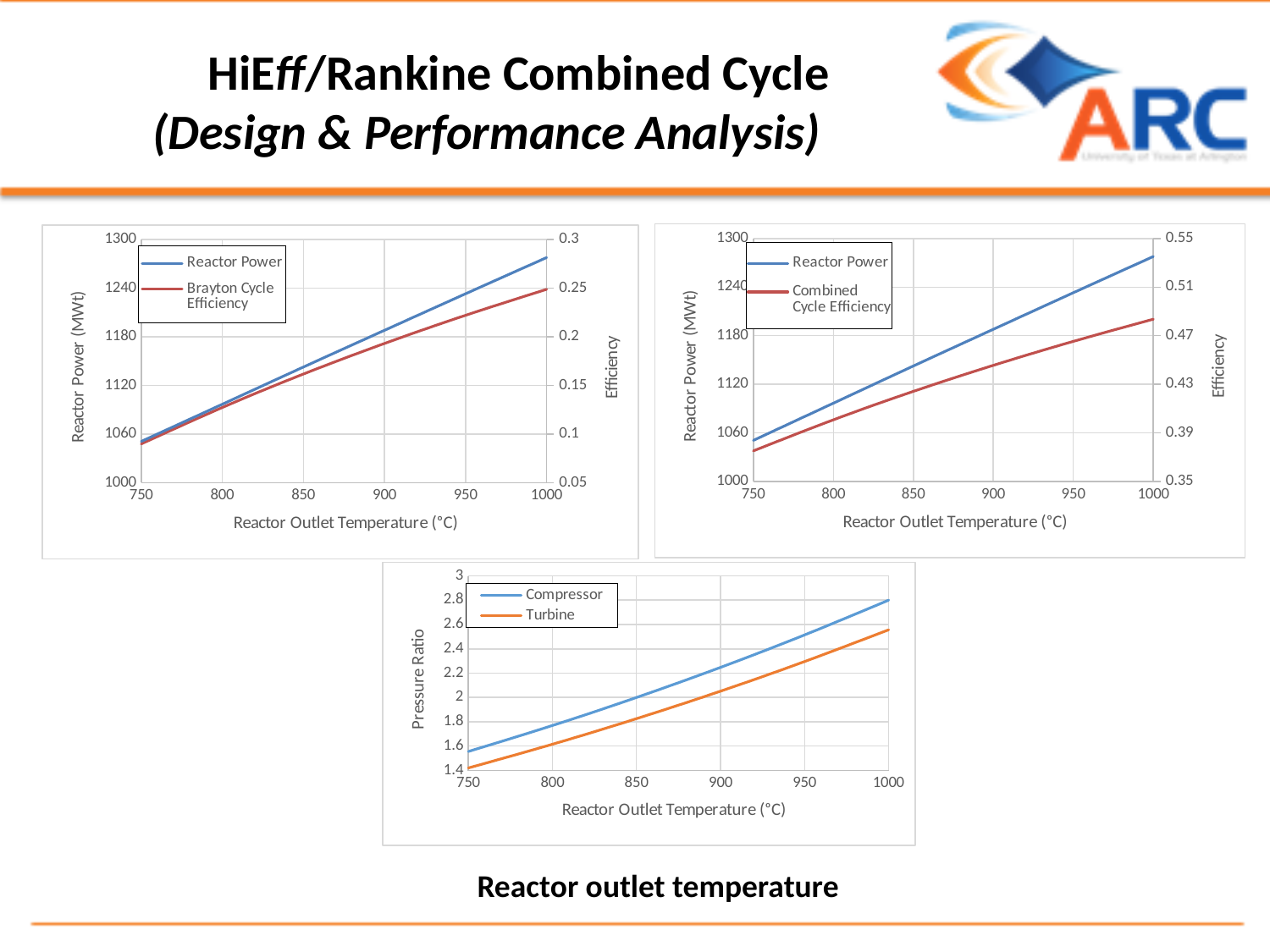
In the top-left chart, is the Brayton Cycle Efficiency at 750 °C greater or less than 0.1? less In the bottom chart, which series has the higher Pressure Ratio at 1000 °C, Compressor or Turbine? Compressor What kind of chart is the top-left chart on the slide? line chart In the top-left chart, is the Reactor Power at 1000 °C greater or less than 1240? greater What is the y-axis title of the bottom chart? Pressure Ratio How many series does the legend of the top-left chart list? 2 In the top-left chart, does Reactor Power rise or fall as Reactor Outlet Temperature increases? rise In the top-right chart, is the Combined Cycle Efficiency at 1000 °C greater or less than 0.47? greater How many series does the legend of the bottom chart list? 2 What are the two series listed in the legend of the top-right chart? Reactor Power and Combined Cycle Efficiency